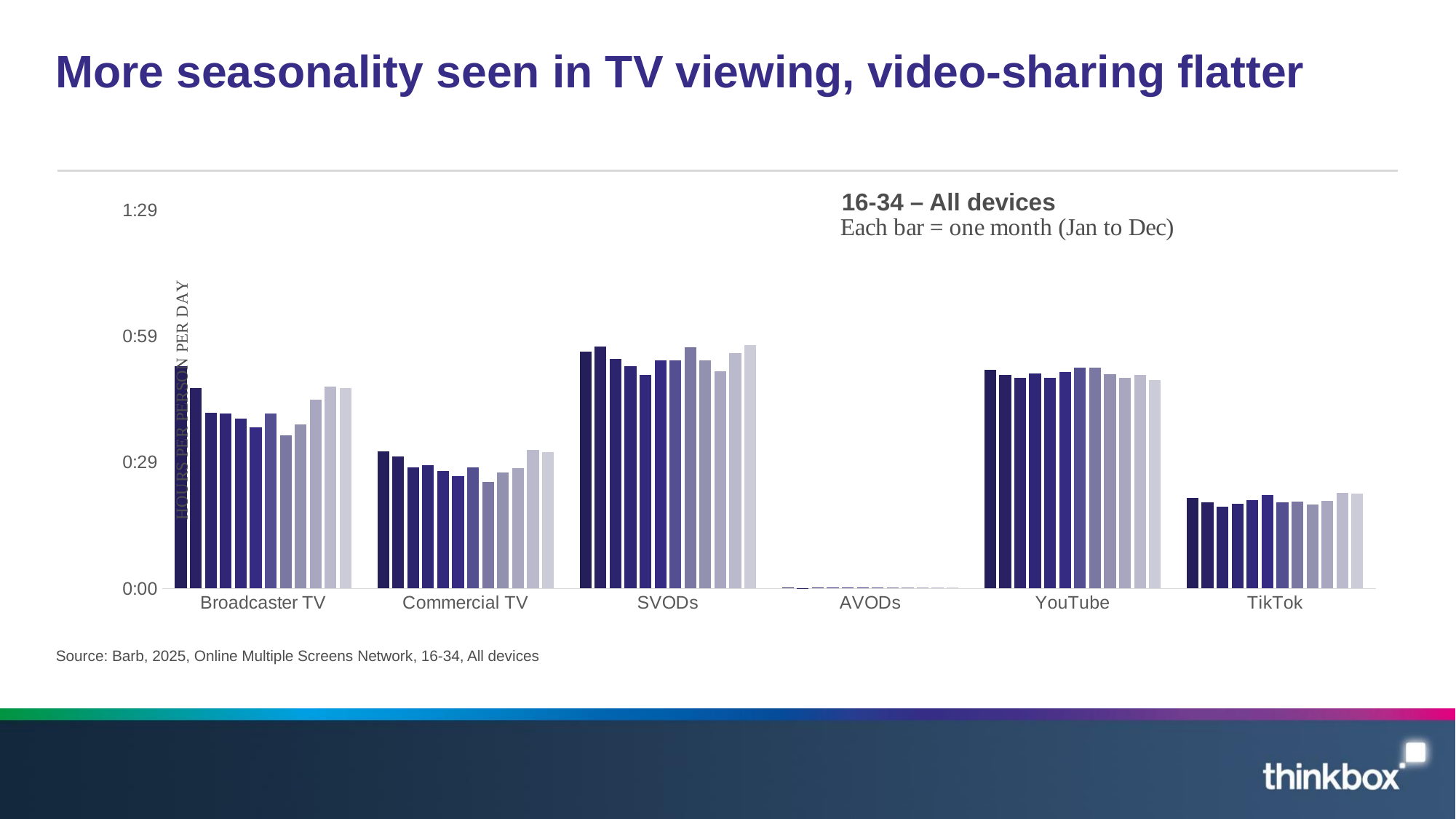
What is the label on the vertical axis? HOURS PER PERSON PER DAY How many bars are plotted for each category? 12 Are the YouTube bars greater or less than 0:29? greater What does each bar in the chart represent, according to the note on the slide? one month (Jan to Dec) Which category has the highest bars? SVODs Are the bars for Broadcaster TV higher or lower than the bars for Commercial TV? higher What kind of chart is shown on the slide? bar chart Are the TikTok bars greater or less than 0:29? less How many categories are shown along the x axis? 6 Which category has the lowest bars? AVODs Is the value for the first (January) bar of Broadcaster TV greater or less than 0:29? greater Are the bars for YouTube higher or lower than the bars for TikTok? higher